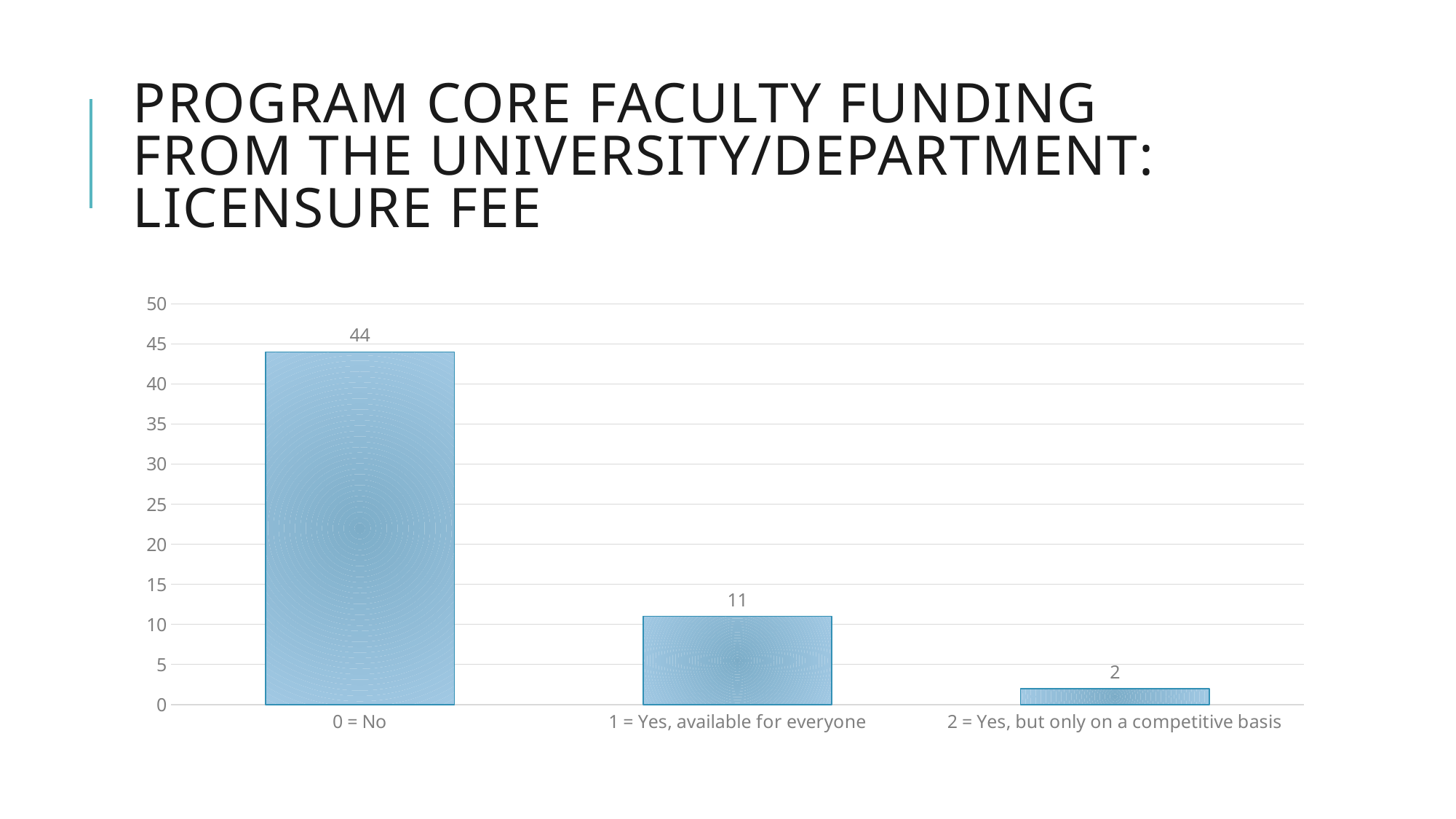
Which category has the lowest value? 2 = Yes, but only on a competitive basis What is the value for the category "0 = No"? 44 Which category has the highest value? 0 = No Is the value for "0 = No" greater or less than 40? greater What kind of chart is shown on the slide? bar chart What is the value for the category "2 = Yes, but only on a competitive basis"? 2 What is the difference between the values for "1 = Yes, available for everyone" and "2 = Yes, but only on a competitive basis"? 9 Which is larger, the value for "1 = Yes, available for everyone" or the value for "2 = Yes, but only on a competitive basis"? 1 = Yes, available for everyone Do the values rise or fall from left to right along the x axis? fall What is the difference between the values for "0 = No" and "1 = Yes, available for everyone"? 33 What is the value for the category "1 = Yes, available for everyone"? 11 How many categories are shown on the x axis? 3